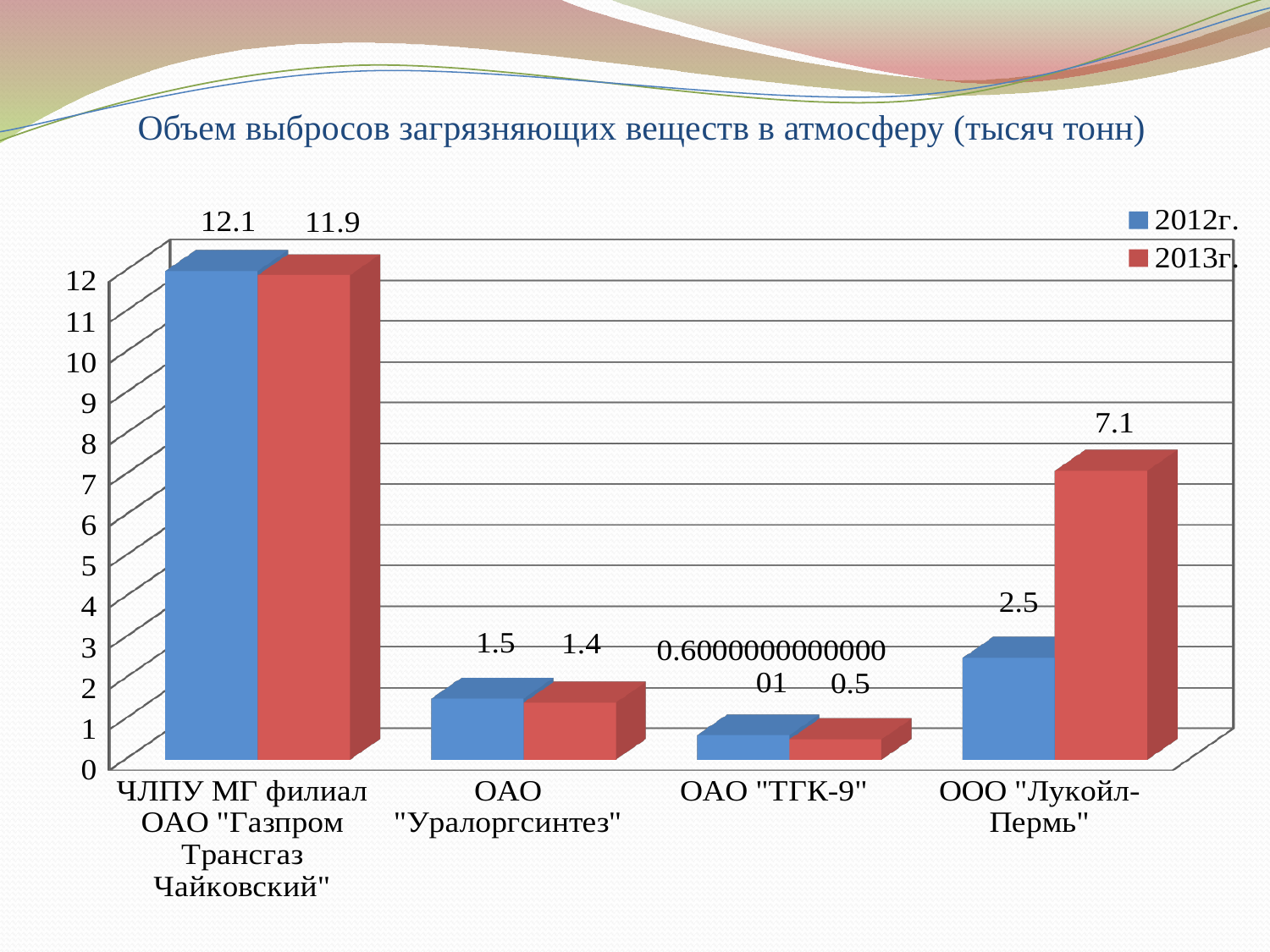
What is the title of the chart? Объем выбросов загрязняющих веществ в атмосферу (тысяч тонн) What is the value for ООО "Лукойл-Пермь" in 2013г.? 7.1 How many series does the legend list? 2 Which is larger for ООО "Лукойл-Пермь": the 2012г. value or the 2013г. value? 2013г. Which category has the lowest value in 2012г.? ОАО "ТГК-9" What is the value for ЧЛПУ МГ филиал ОАО "Газпром Трансгаз Чайковский" in 2012г.? 12.1 Which category has the highest value in 2013г.? ЧЛПУ МГ филиал ОАО "Газпром Трансгаз Чайковский" What kind of chart is shown on the slide? Bar chart What is the value for ОАО "Уралоргсинтез" in 2013г.? 1.4 What is the value for ОАО "ТГК-9" in 2013г.? 0.5 What is the difference between the 2013г. and 2012г. values for ООО "Лукойл-Пермь"? 4.6 How many categories are shown on the x axis? 4